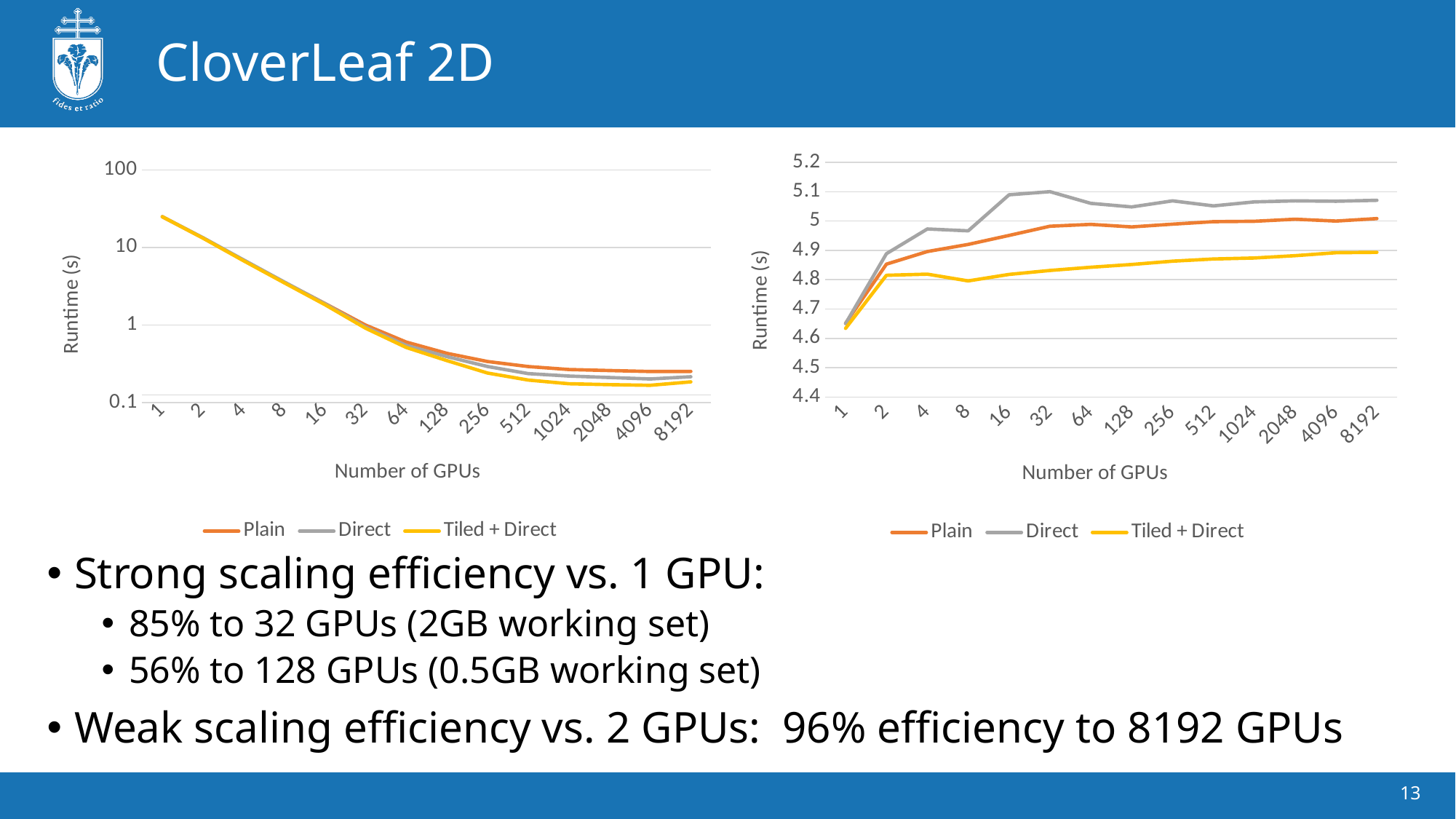
In the right-hand chart, which series has the highest runtime at 32 GPUs? Direct What is the label of the y axis on the left-hand chart? Runtime (s) In the right-hand chart, which series has the lowest runtime at 8192 GPUs? Tiled + Direct In the right-hand chart, is the Direct runtime at 32 GPUs greater or less than 5? greater What kind of chart is the chart on the left of the slide? line chart In the right-hand chart, is the Tiled + Direct runtime at 8192 GPUs greater or less than 5? less How many series does the legend of the right-hand chart list? 3 In the left-hand chart, is the Plain runtime at 1 GPU greater or less than 10? greater In the left-hand chart, do the runtime values rise or fall as the number of GPUs increases? fall How many Number of GPUs categories are shown on the x axis of the left-hand chart? 14 In the right-hand chart, do the runtime values generally rise or fall as the number of GPUs increases from 1 to 8192? rise